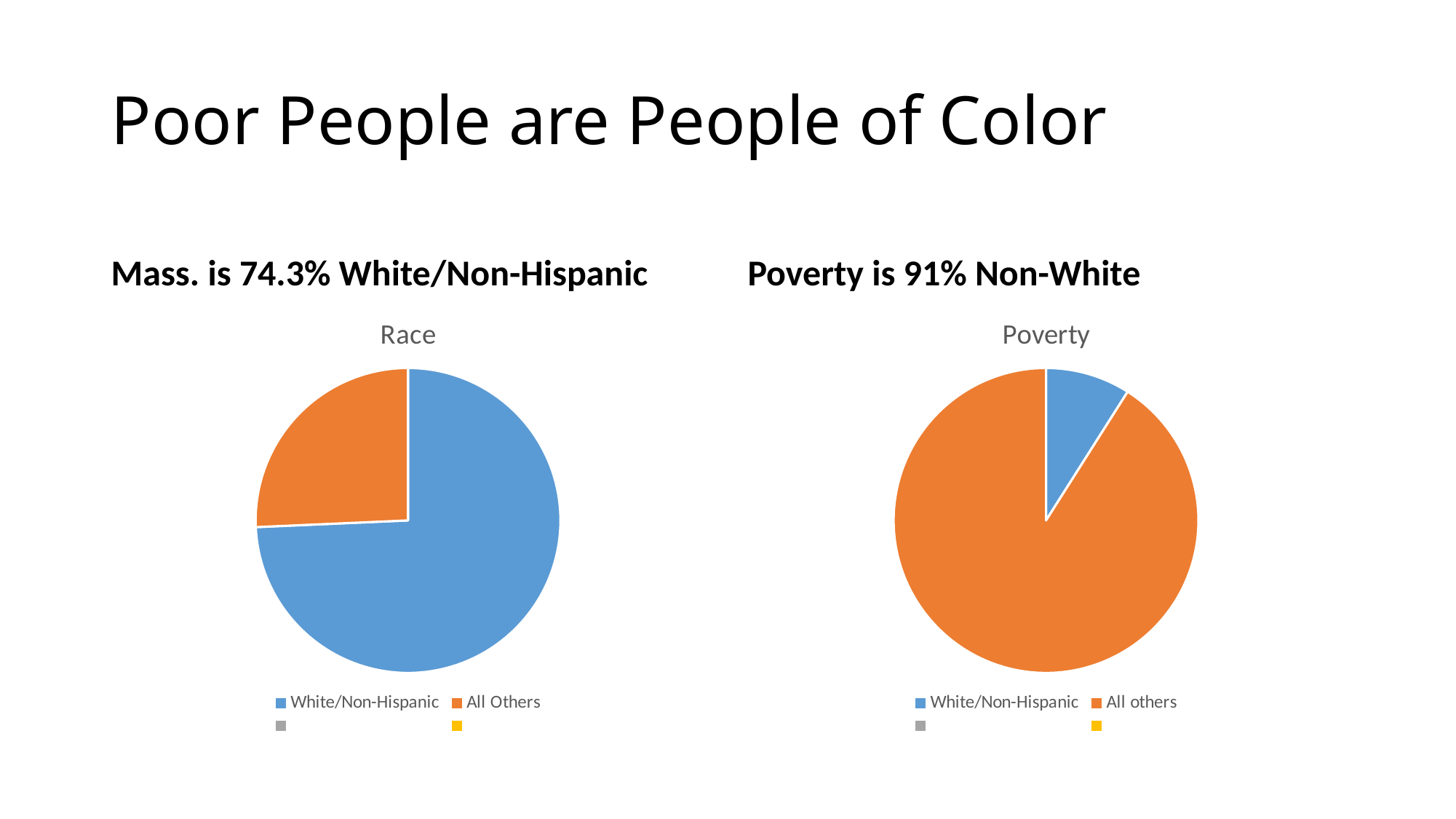
In the Poverty chart, which is larger, the White/Non-Hispanic slice or the All others slice? All others In the Race chart, which slice is the smallest? All Others What colour is the White/Non-Hispanic slice in the Poverty chart? blue What kind of chart is the Race chart? pie chart In the Race chart, which slice is the largest? White/Non-Hispanic According to the heading above the Race chart, what share of Massachusetts is White/Non-Hispanic? 74.3% In the Poverty chart, which slice is the smallest? White/Non-Hispanic In the Race chart, which is larger, the White/Non-Hispanic slice or the All Others slice? White/Non-Hispanic What kind of chart is the Poverty chart? pie chart How many slices does the Poverty pie chart have? 2 How many slices does the Race pie chart have? 2 In the Poverty chart, which slice is the largest? All others